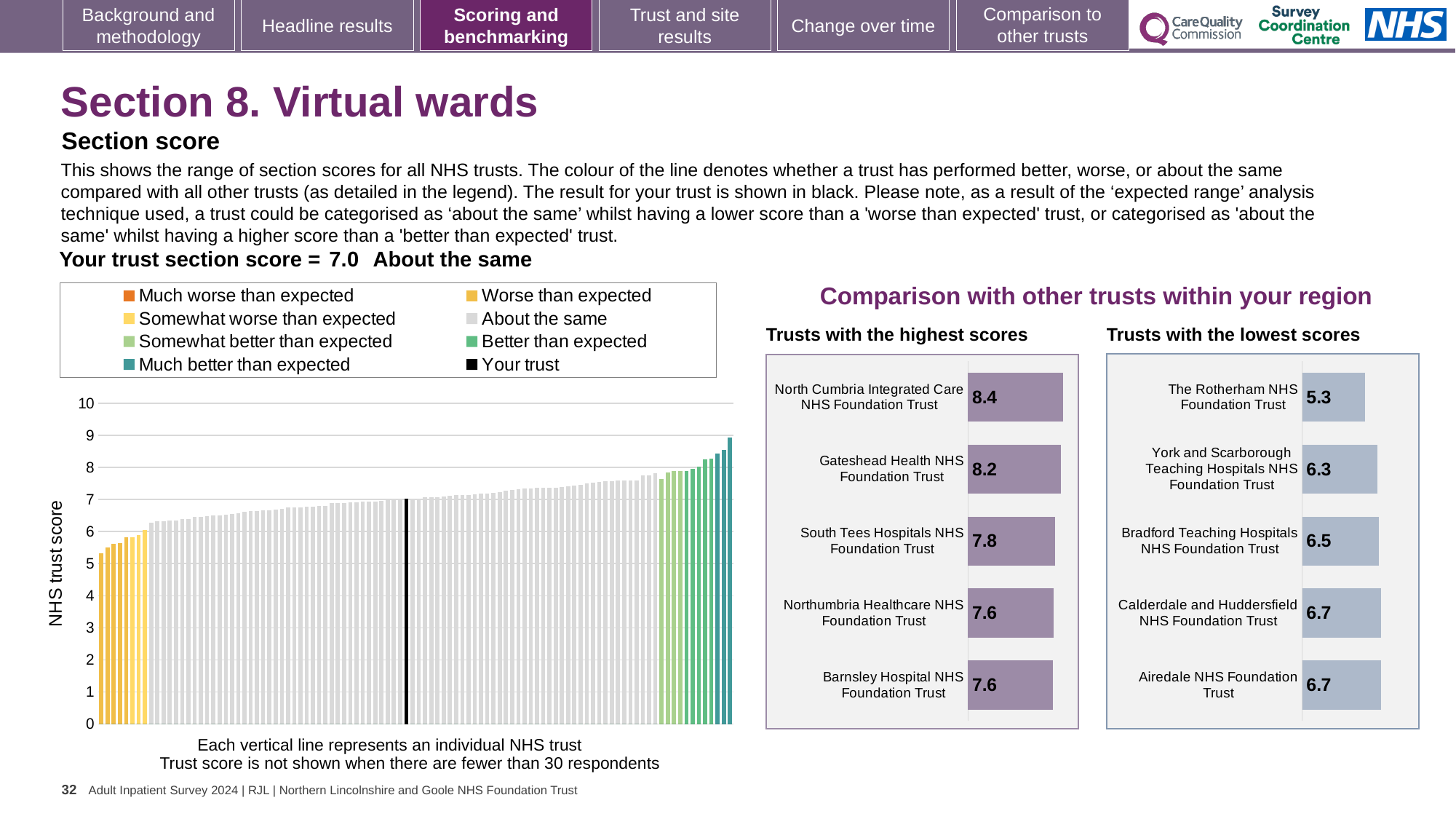
In the main NHS trust score chart on the left, what is the section score for your trust (the black bar)? 7.0 What kind of chart is the main NHS trust score chart on the left? Bar chart In the 'Trusts with the lowest scores' chart, what is the difference between the scores of Bradford Teaching Hospitals NHS Foundation Trust and The Rotherham NHS Foundation Trust? 1.2 In the 'Trusts with the highest scores' chart, what is the difference between the scores of North Cumbria Integrated Care NHS Foundation Trust and Gateshead Health NHS Foundation Trust? 0.2 In the main NHS trust score chart on the left, do the bar values rise or fall from left to right? Rise In the main NHS trust score chart on the left, how many entries does the legend list? 8 In the 'Trusts with the lowest scores' chart, which trust has the lowest score? The Rotherham NHS Foundation Trust In the 'Trusts with the lowest scores' chart, what is the score for The Rotherham NHS Foundation Trust? 5.3 In the 'Trusts with the highest scores' chart, how many trusts are shown? 5 In the 'Trusts with the highest scores' chart, which trust has the highest score? North Cumbria Integrated Care NHS Foundation Trust In the 'Trusts with the highest scores' chart, which has the larger score: South Tees Hospitals NHS Foundation Trust or Northumbria Healthcare NHS Foundation Trust? South Tees Hospitals NHS Foundation Trust In the 'Trusts with the highest scores' chart, what is the score for North Cumbria Integrated Care NHS Foundation Trust? 8.4